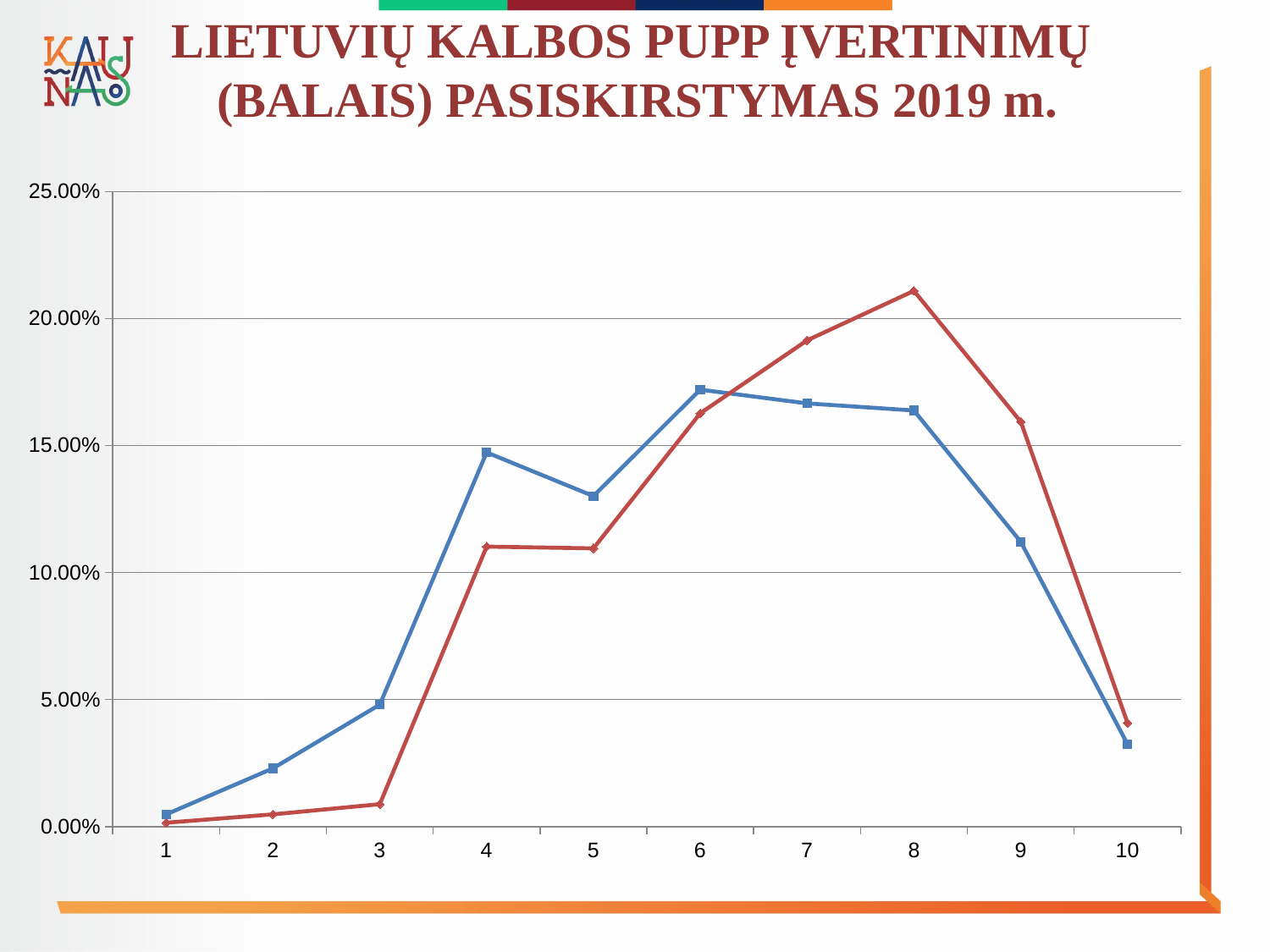
At x-axis value 8, which line is higher, the blue or the red? red At which x-axis value does the red line reach its highest point? 8 At x-axis value 4, which line is higher, the blue or the red? blue How many points are marked along the x axis of the chart? 10 Is the value of the blue line at 10 greater or less than 5.00%? less How many lines are plotted on the chart? 2 At which x-axis value is the red line at its lowest? 1 What kind of chart is shown on the slide? line chart Is the value of the red line at 8 greater or less than 20.00%? greater Is the value of the blue line at 5 greater or less than 15.00%? less Does the red line rise or fall between 8 and 10 on the x axis? fall